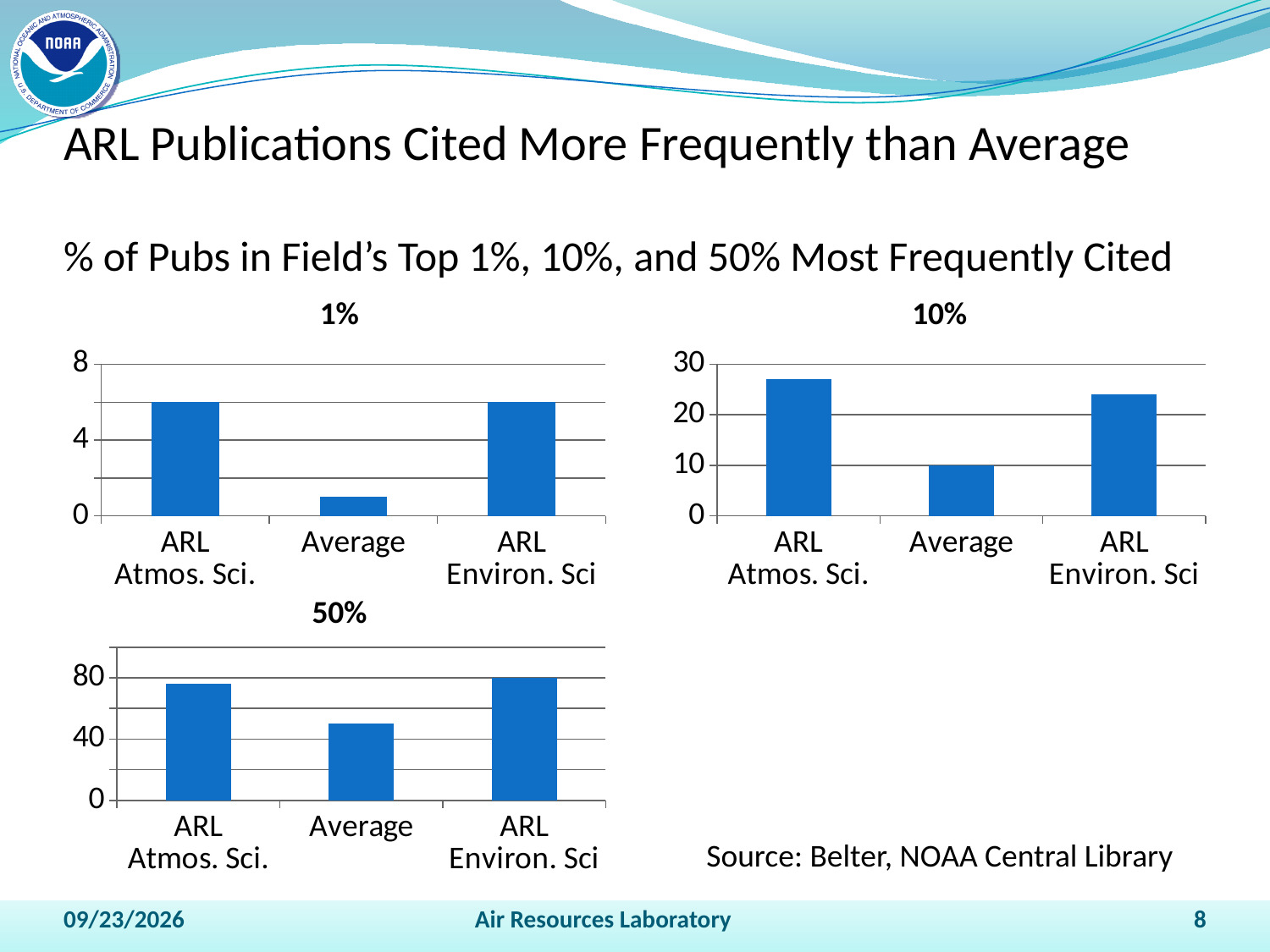
How many charts are shown on the slide? 3 In the chart titled "10%", what is the value for Average? 10 In the chart titled "10%", is the value for ARL Environ. Sci greater or less than 20? greater In the chart titled "1%", how many categories are plotted? 3 In the chart titled "1%", is the value for Average greater or less than 4? less In the chart titled "1%", what kind of chart is shown? bar chart In the chart titled "1%", is the value for ARL Atmos. Sci. greater or less than 4? greater In the chart titled "10%", which category has the lowest value? Average In the chart titled "50%", which is larger, the value for ARL Environ. Sci or the value for Average? ARL Environ. Sci In the chart titled "10%", which category has the highest value? ARL Atmos. Sci. In the chart titled "50%", which category has the lowest value? Average